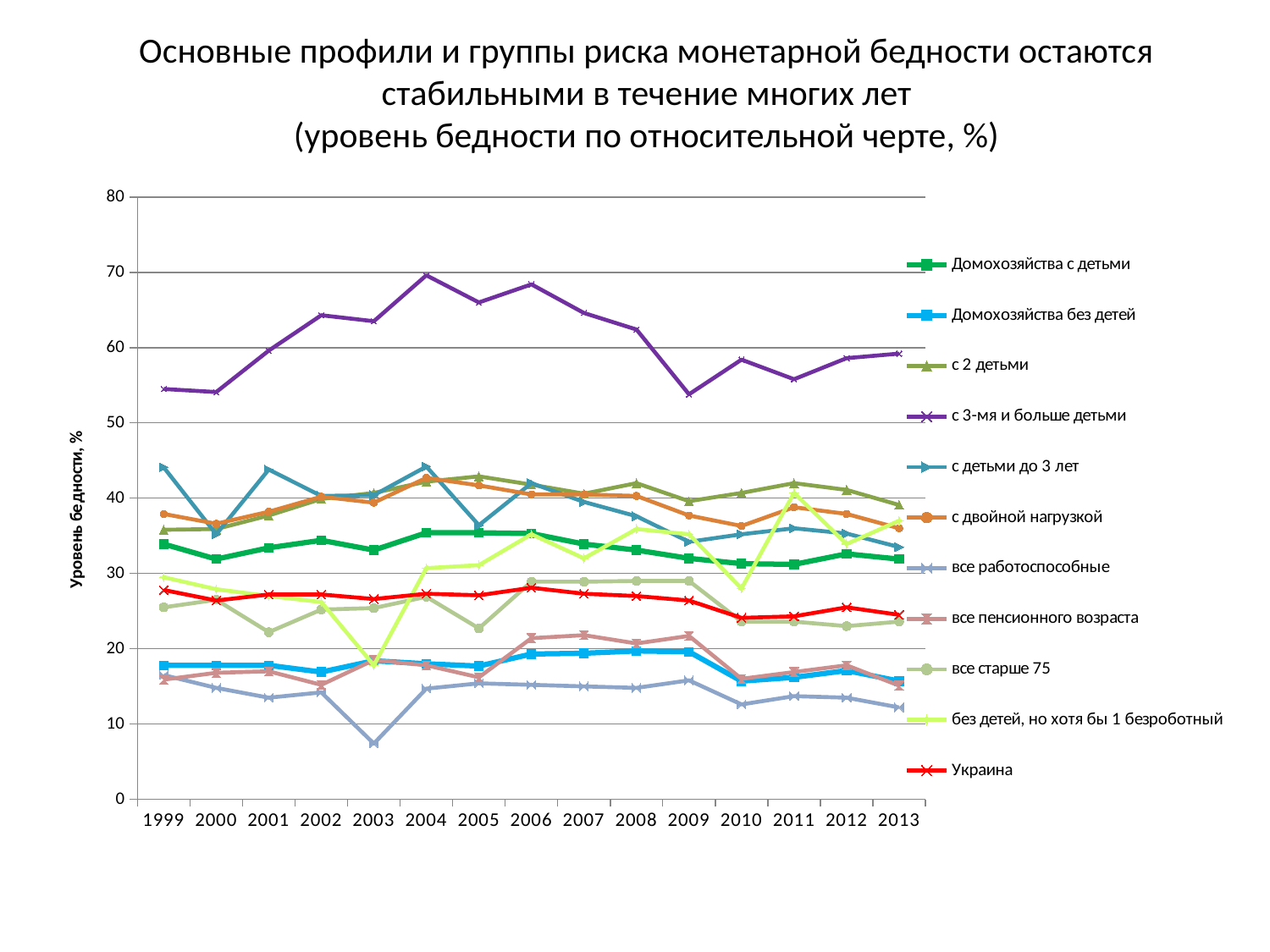
How many years are shown along the x axis? 15 Is the value for 'Домохозяйства с детьми' in 1999 greater or less than 30? greater What kind of chart is shown on the slide? line chart Is the value for 'все работоспособные' in 2003 greater or less than 10? less Which series has the highest values across all years? с 3-мя и больше детьми Is the value for 'с 3-мя и больше детьми' in 2004 greater or less than 60? greater Which series has the lowest value in 2003? все работоспособные Does the 'с 3-мя и больше детьми' series rise or fall from 2004 to 2009? fall What is the title of the vertical axis? Уровень бедности, % In 2013, which is larger: 'Домохозяйства с детьми' or 'Домохозяйства без детей'? Домохозяйства с детьми How many series does the legend list? 11